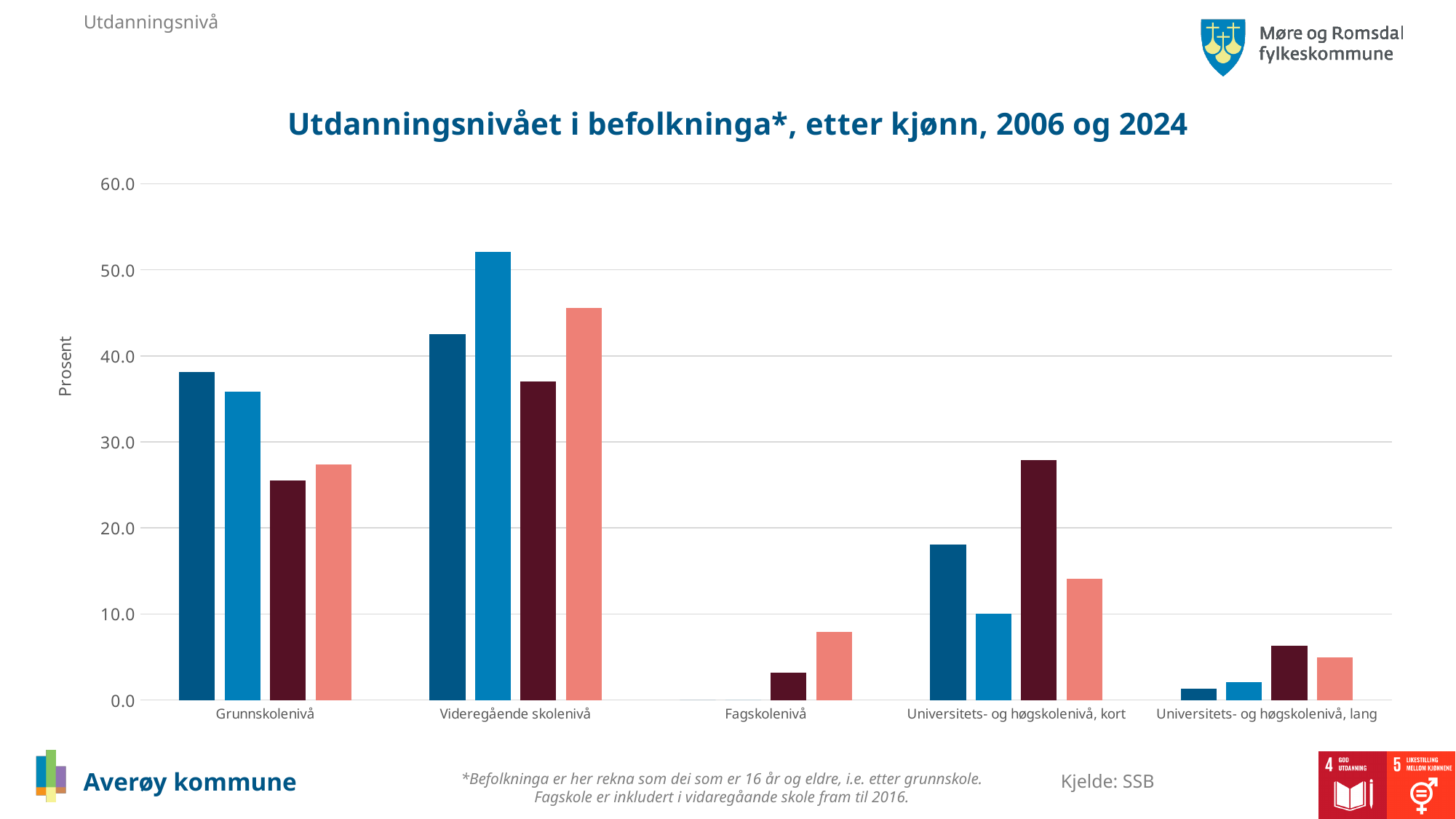
Which category contains the tallest bar in the chart? Videregående skolenivå Is the tallest bar for Fagskolenivå greater or less than 10? less Is the tallest bar for Videregående skolenivå greater or less than 50? greater Is the tallest bar for Universitets- og høgskolenivå, lang greater or less than 10? less What is the title of the chart? Utdanningsnivået i befolkninga*, etter kjønn, 2006 og 2024 How many education-level categories are shown on the x axis? 5 Which category has the larger dark blue (first) bar: Grunnskolenivå or Videregående skolenivå? Videregående skolenivå What is the label on the y axis? Prosent What kind of chart is shown on the slide? bar chart